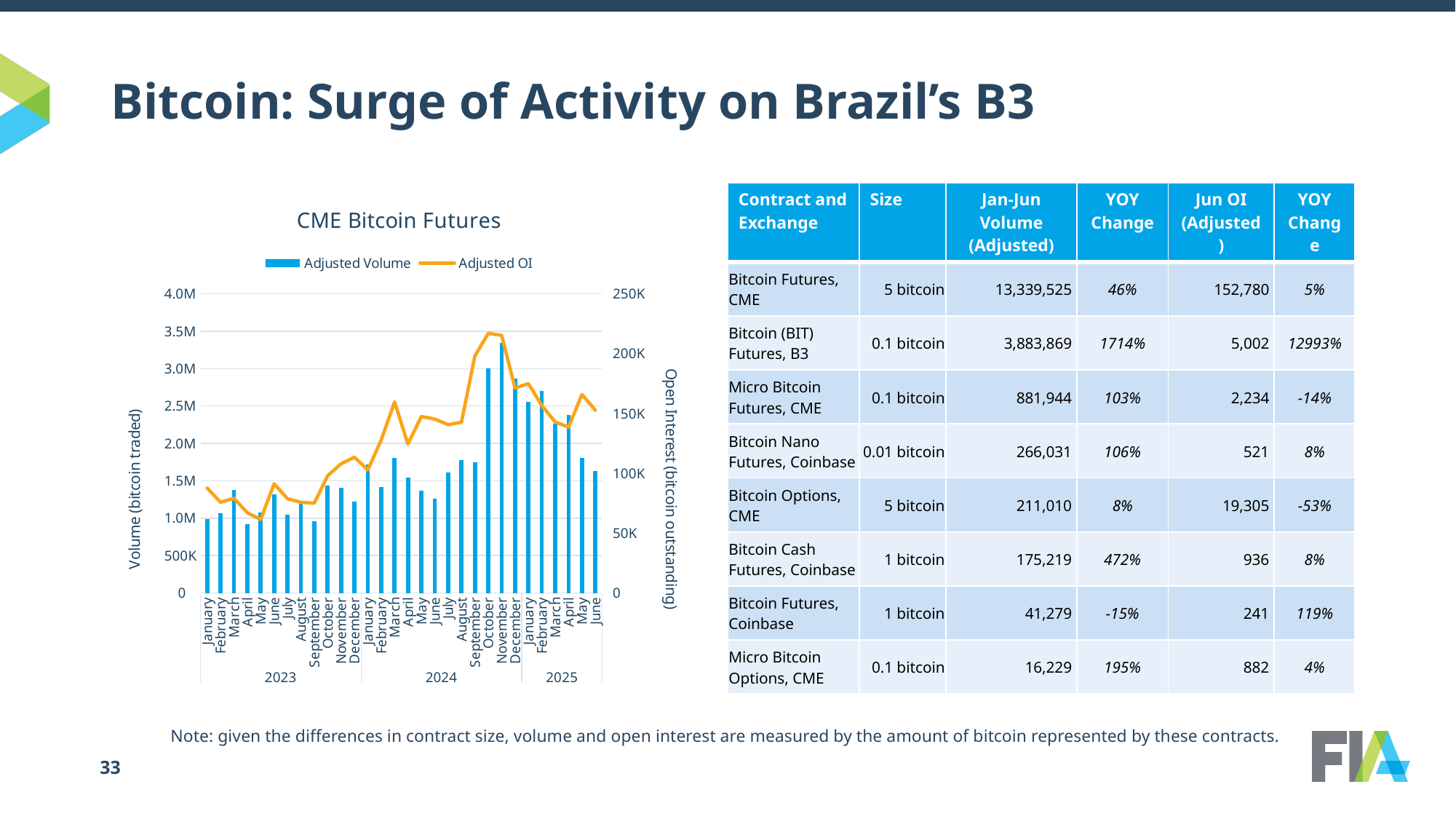
Is the Adjusted Volume for March 2023 greater or less than 1.0M? greater Which month has the larger Adjusted Volume, January 2023 or October 2024? October 2024 Does the Adjusted OI line generally rise or fall from January 2023 to October 2024? rise What are the two series named in the legend of the CME Bitcoin Futures chart? Adjusted Volume and Adjusted OI How many series does the legend of the CME Bitcoin Futures chart list? 2 How many months are plotted on the x axis of the CME Bitcoin Futures chart? 30 In which month does the Adjusted Volume bar reach its highest value on the CME Bitcoin Futures chart? November 2024 Is the Adjusted OI for May 2023 greater or less than 100K? less What is the label of the left vertical axis on the CME Bitcoin Futures chart? Volume (bitcoin traded) Is the Adjusted Volume for October 2024 greater or less than 2.5M? greater What kind of chart is the CME Bitcoin Futures chart? A combined bar and line chart